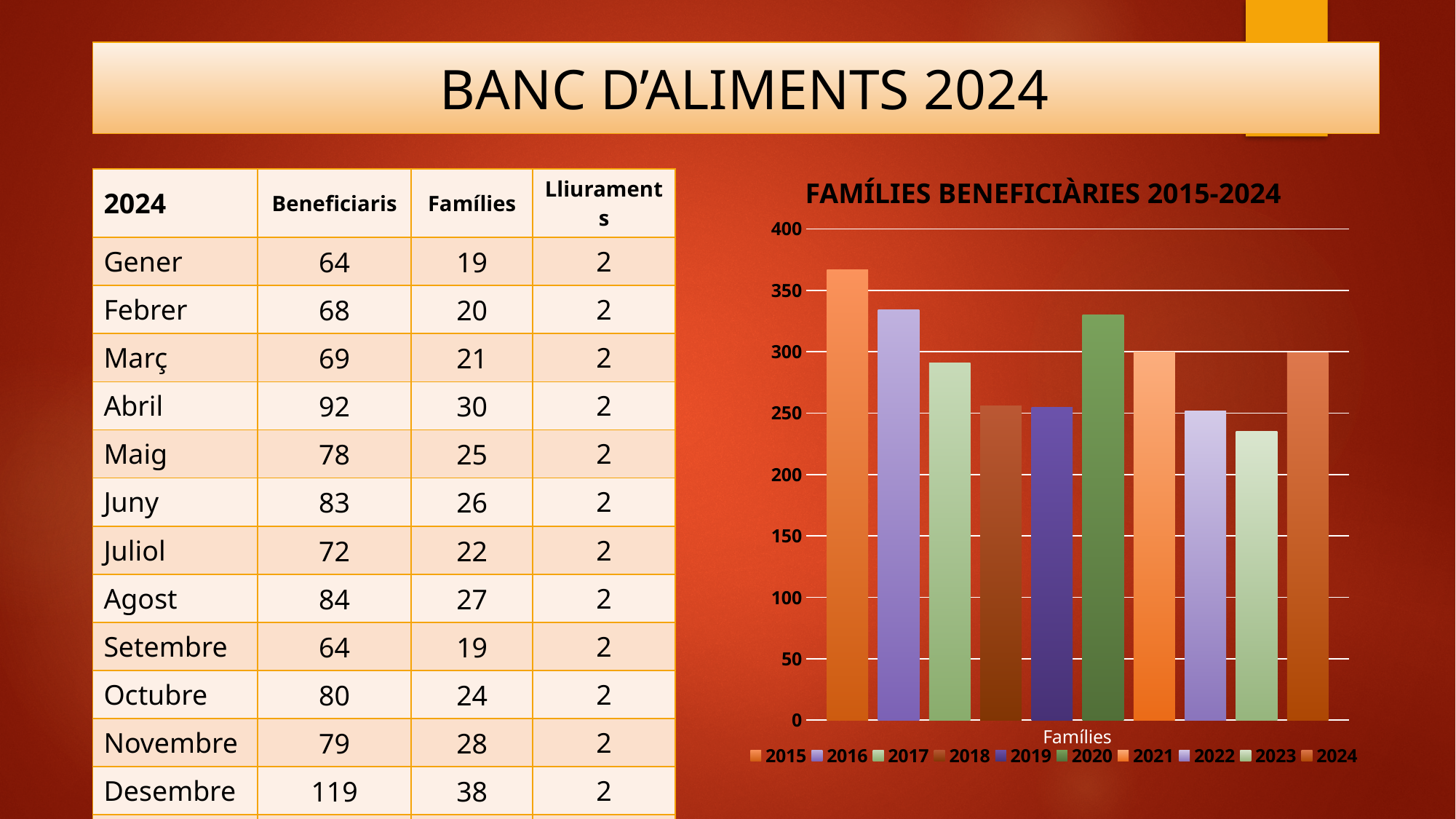
How many categories are shown on the x axis of the chart? 1 Which is larger, the value for 2016 or the value for 2017? 2016 Which is larger, the value for 2018 or the value for 2020? 2020 Is the value for 2017 greater or less than 300? less What is the title of the chart? FAMÍLIES BENEFICIÀRIES 2015-2024 Is the value for 2023 greater or less than 250? less Is the value for 2020 greater or less than 300? greater What kind of chart is shown on the slide? bar chart How many series does the chart legend list? 10 Which year has the highest bar in the chart? 2015 Which year has the lowest bar in the chart? 2023